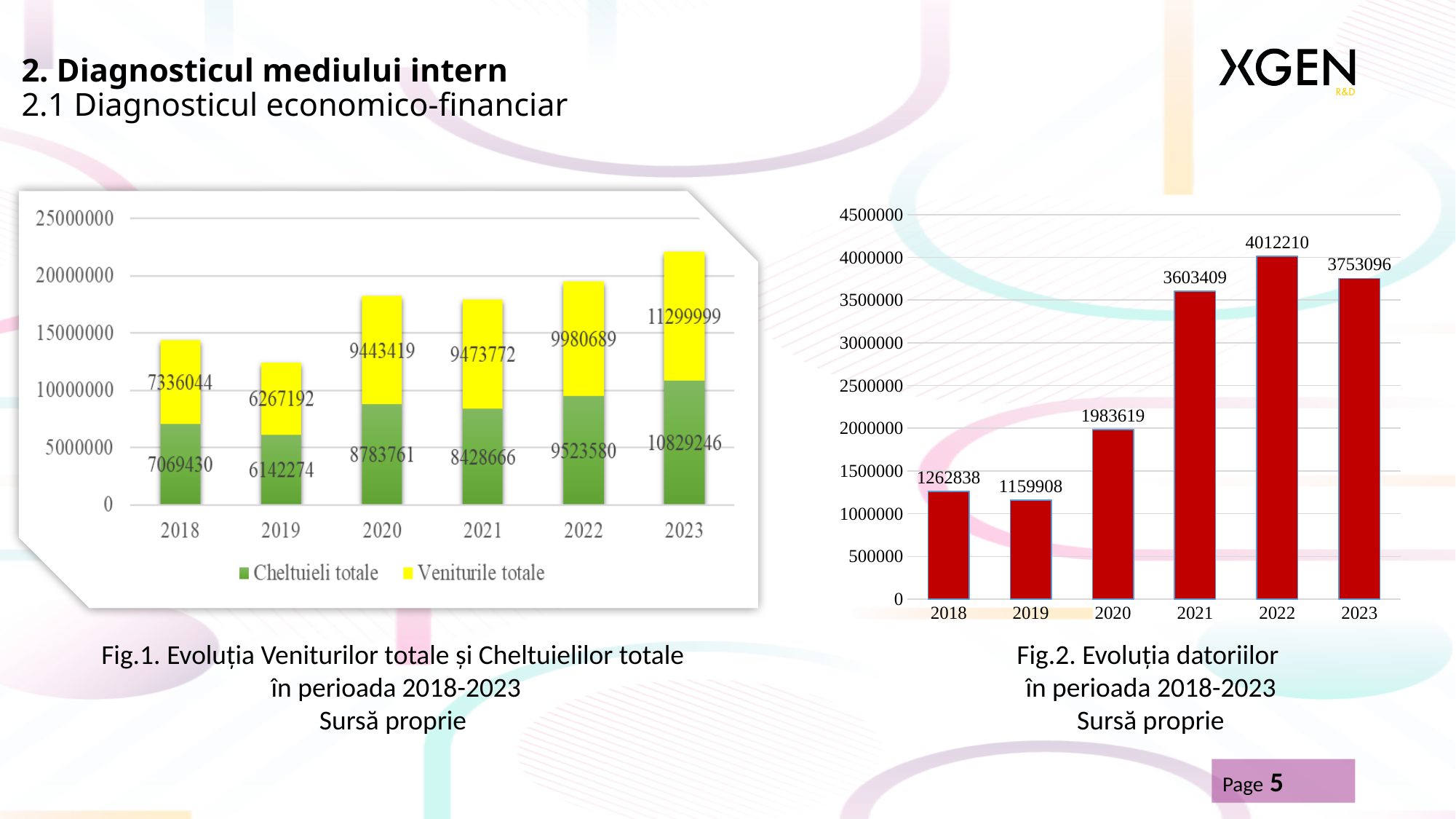
In Fig.1, what is the value of Cheltuieli totale for 2019? 6142274 How many series does the legend of Fig.1 list? 2 In Fig.1, what is the difference between Veniturile totale and Cheltuieli totale in 2023? 470753 In Fig.1, what is the total height of the stacked bar for 2023? 22129245 What kind of chart is Fig.2? Bar chart In Fig.2, what is the difference between the values for 2022 and 2021? 408801 In Fig.2, which year has the highest value? 2022 In Fig.1, which year has the lowest value of Veniturile totale? 2019 In Fig.2, is the value for 2020 larger than the value for 2018? Yes In Fig.2 (Evoluția datoriilor), what is the value for 2022? 4012210 In Fig.1 (Evoluția Veniturilor totale și Cheltuielilor totale), what is the value of Veniturile totale for 2020? 9443419 In Fig.2, which year has the lowest value? 2019